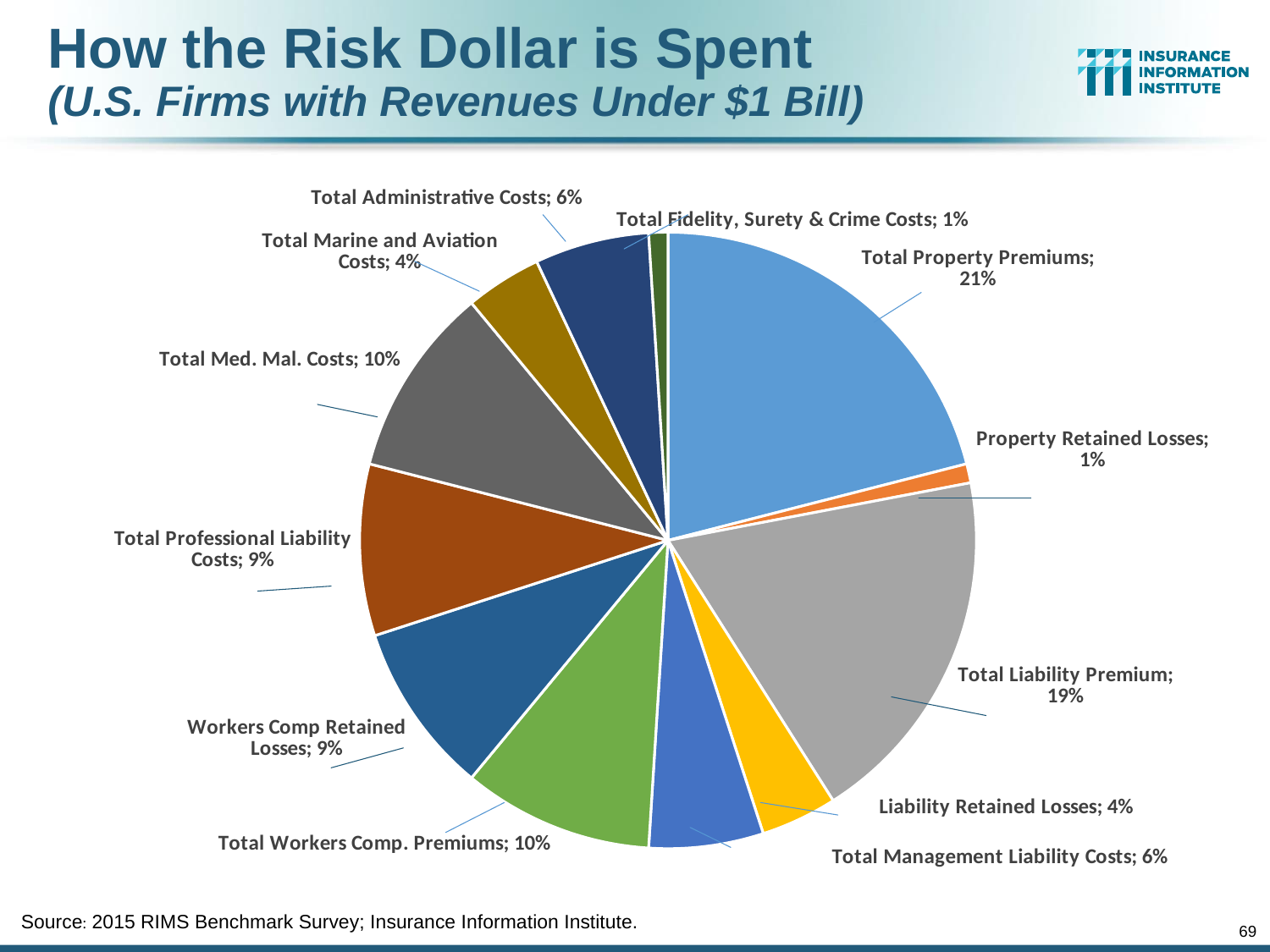
What is the difference between Total Property Premiums and Total Liability Premium? 2% What percentage is labelled for Total Marine and Aviation Costs? 4% What is the title of the chart on the slide? How the Risk Dollar is Spent (U.S. Firms with Revenues Under $1 Bill) Which category has the largest slice of the pie? Total Property Premiums What share is shown for Total Fidelity, Surety & Crime Costs? 1% What percentage is shown for Total Liability Premium? 19% What kind of chart is shown on the slide? Pie chart What is the value for Total Med. Mal. Costs? 10% What share of the risk dollar goes to Total Property Premiums? 21% What share of the pie does Workers Comp Retained Losses represent? 9% Which is larger, Total Med. Mal. Costs or Total Professional Liability Costs? Total Med. Mal. Costs How many slices does the pie chart have? 12